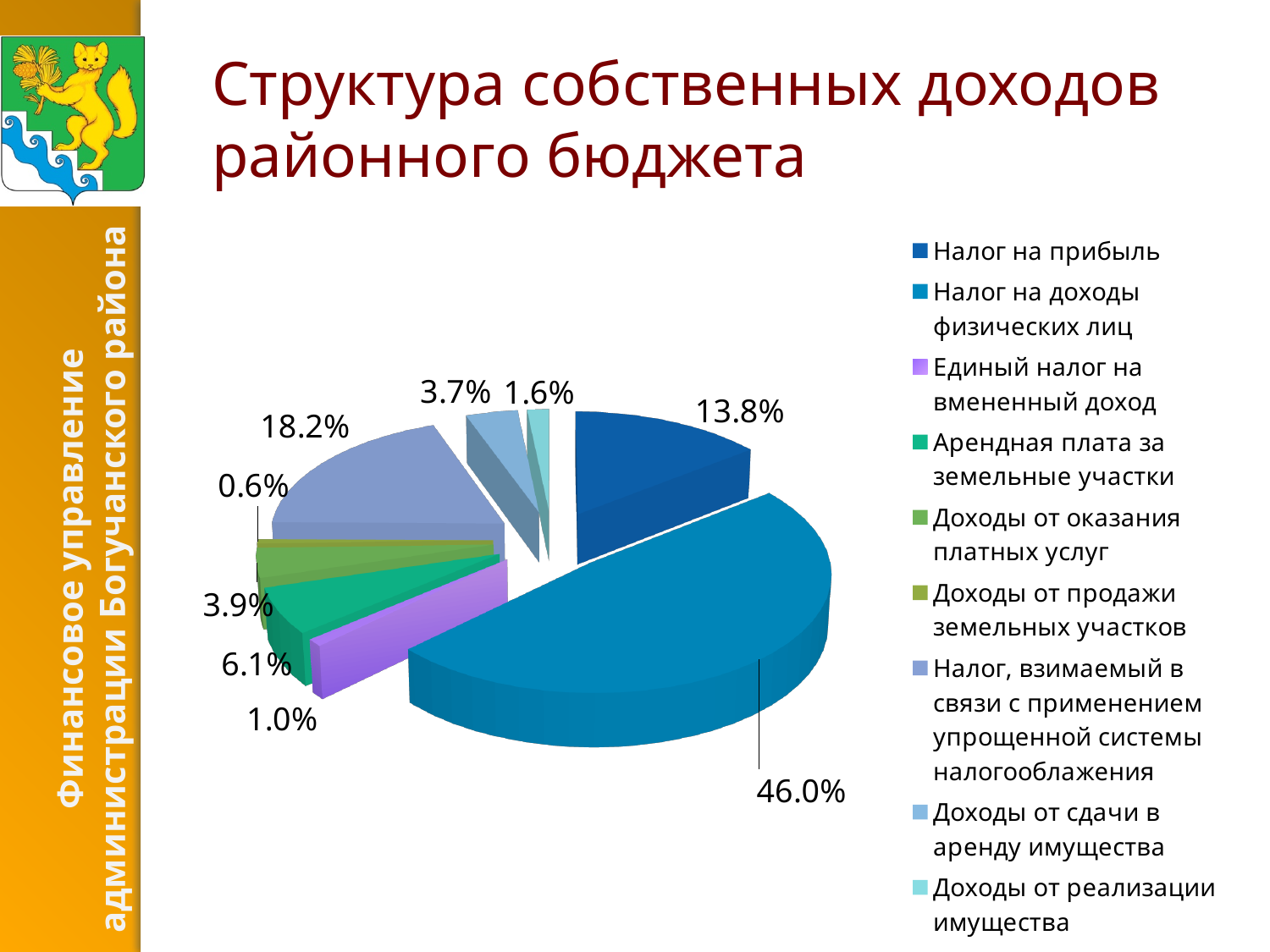
How many entries does the legend list? 9 What share of the pie is 'Доходы от сдачи в аренду имущества'? 3.7% What is the title of the chart on the slide? Структура собственных доходов районного бюджета Which category has the largest share of the pie? Налог на доходы физических лиц What share of the pie is 'Налог, взимаемый в связи с применением упрощенной системы налогообложения'? 18.2% What kind of chart is shown on the slide? Pie chart Which is larger: the share of 'Налог на прибыль' or the share of 'Налог, взимаемый в связи с применением упрощенной системы налогообложения'? Налог, взимаемый в связи с применением упрощенной системы налогообложения What share of the pie is 'Налог на прибыль'? 13.8% How many slices does the pie chart have? 9 What is the smallest percentage shown on the pie chart? 0.6%